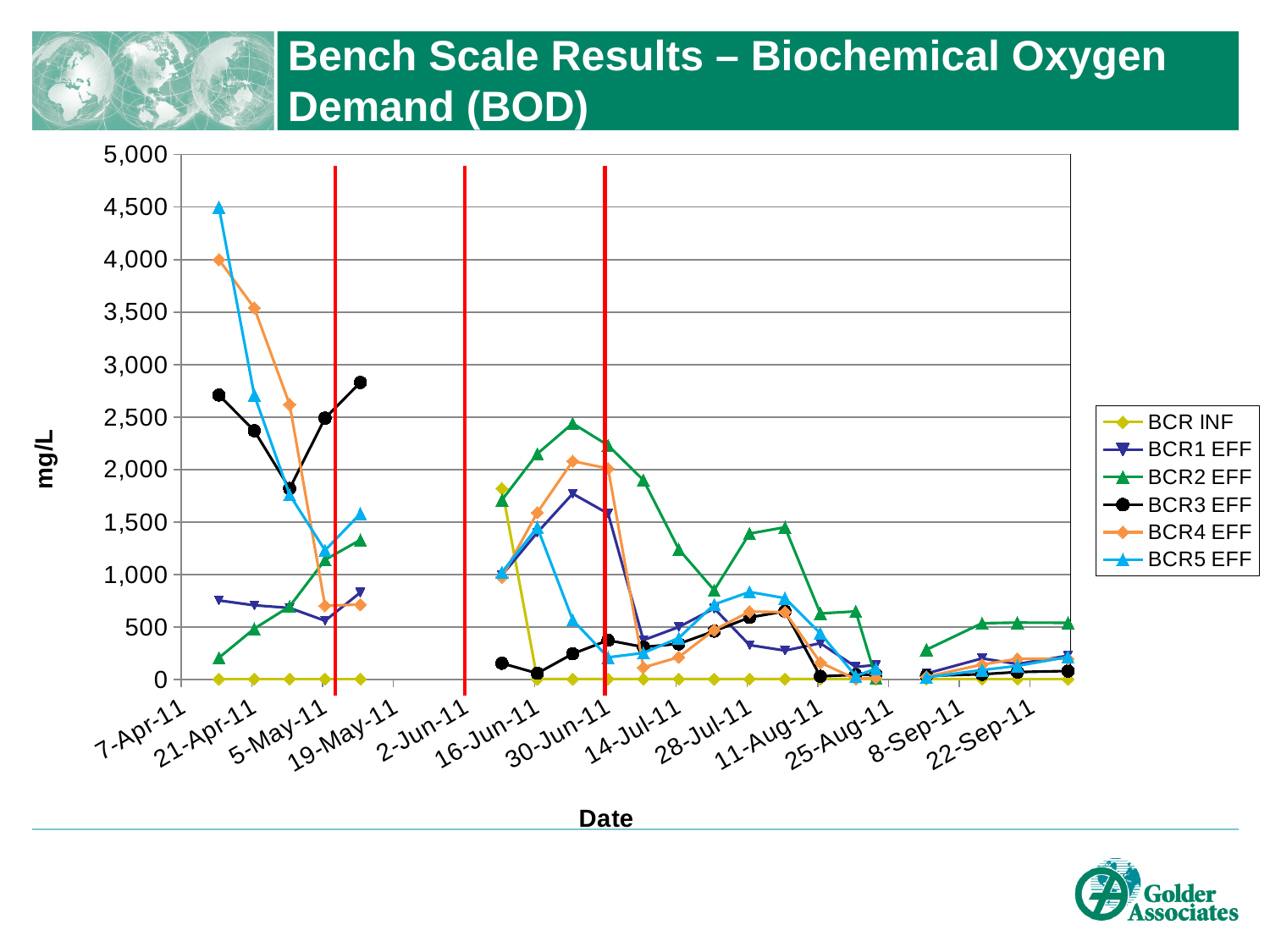
What kind of chart is shown on the slide? line chart How many vertical red lines are drawn on the chart? 3 What is the label on the vertical axis? mg/L How many series does the legend list? 6 Which series reaches the highest value around 30-Jun-11? BCR2 EFF